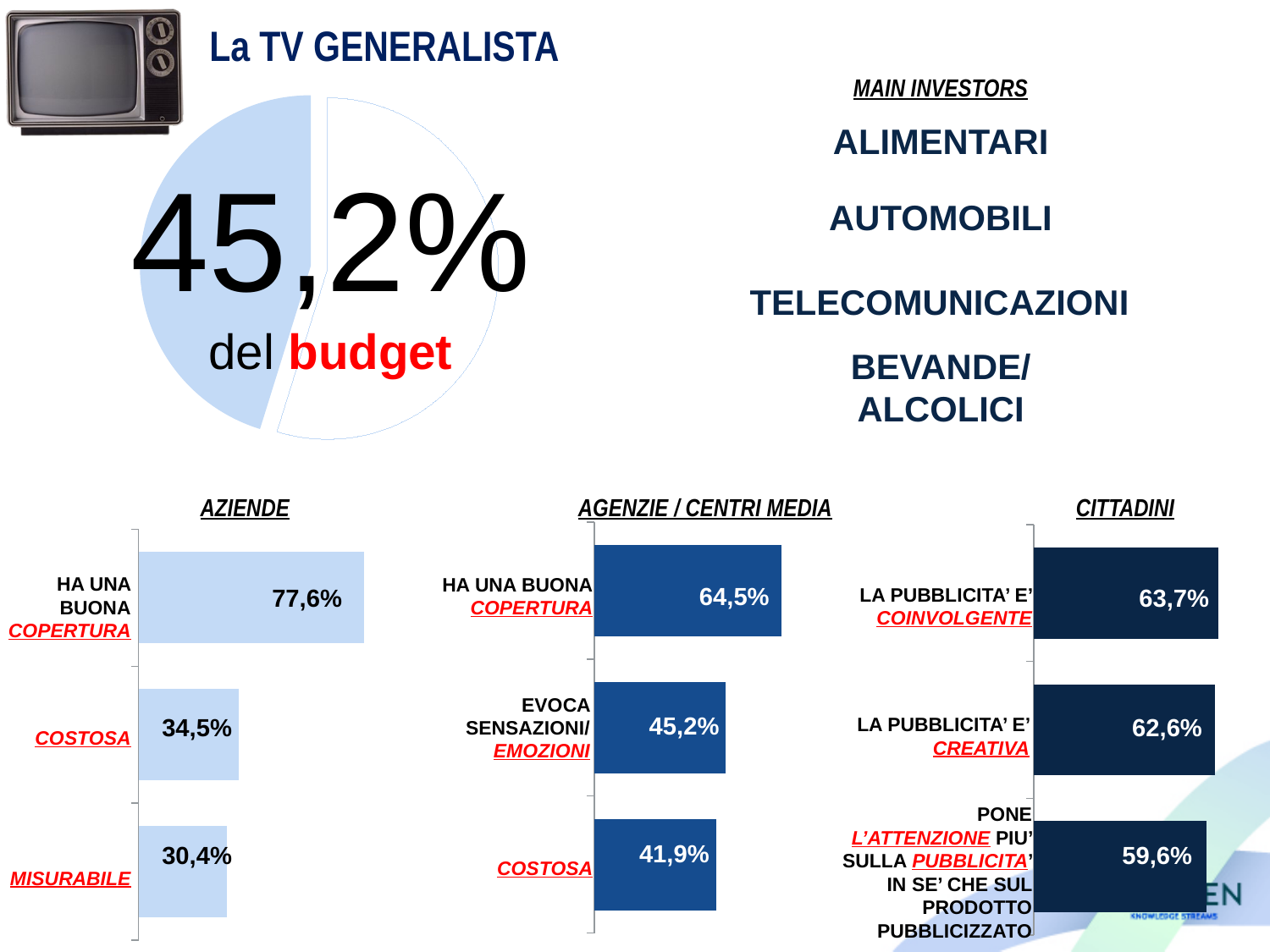
How many categories does the CITTADINI bar chart show? 3 What kind of chart is used for the AZIENDE, AGENZIE / CENTRI MEDIA and CITTADINI data? Bar chart In the CITTADINI bar chart, which category has the lowest value? PONE L'ATTENZIONE PIU' SULLA PUBBLICITA' IN SE' CHE SUL PRODOTTO PUBBLICIZZATO In the AZIENDE bar chart, what is the value for MISURABILE? 30,4% In the AGENZIE / CENTRI MEDIA bar chart, what is the value for EVOCA SENSAZIONI/EMOZIONI? 45,2% In the AGENZIE / CENTRI MEDIA bar chart, what is the difference between HA UNA BUONA COPERTURA and COSTOSA? 22,6% In the AZIENDE bar chart, what is the difference between the values for COSTOSA and MISURABILE? 4,1% In the CITTADINI bar chart, what is the value for LA PUBBLICITA' E' CREATIVA? 62,6% Which is larger: the value for COSTOSA in the AZIENDE chart or the value for COSTOSA in the AGENZIE / CENTRI MEDIA chart? AGENZIE / CENTRI MEDIA In the AGENZIE / CENTRI MEDIA bar chart, which category has the lowest value? COSTOSA In the AZIENDE bar chart, what is the value for HA UNA BUONA COPERTURA? 77,6% In the AZIENDE bar chart, which category has the highest value? HA UNA BUONA COPERTURA